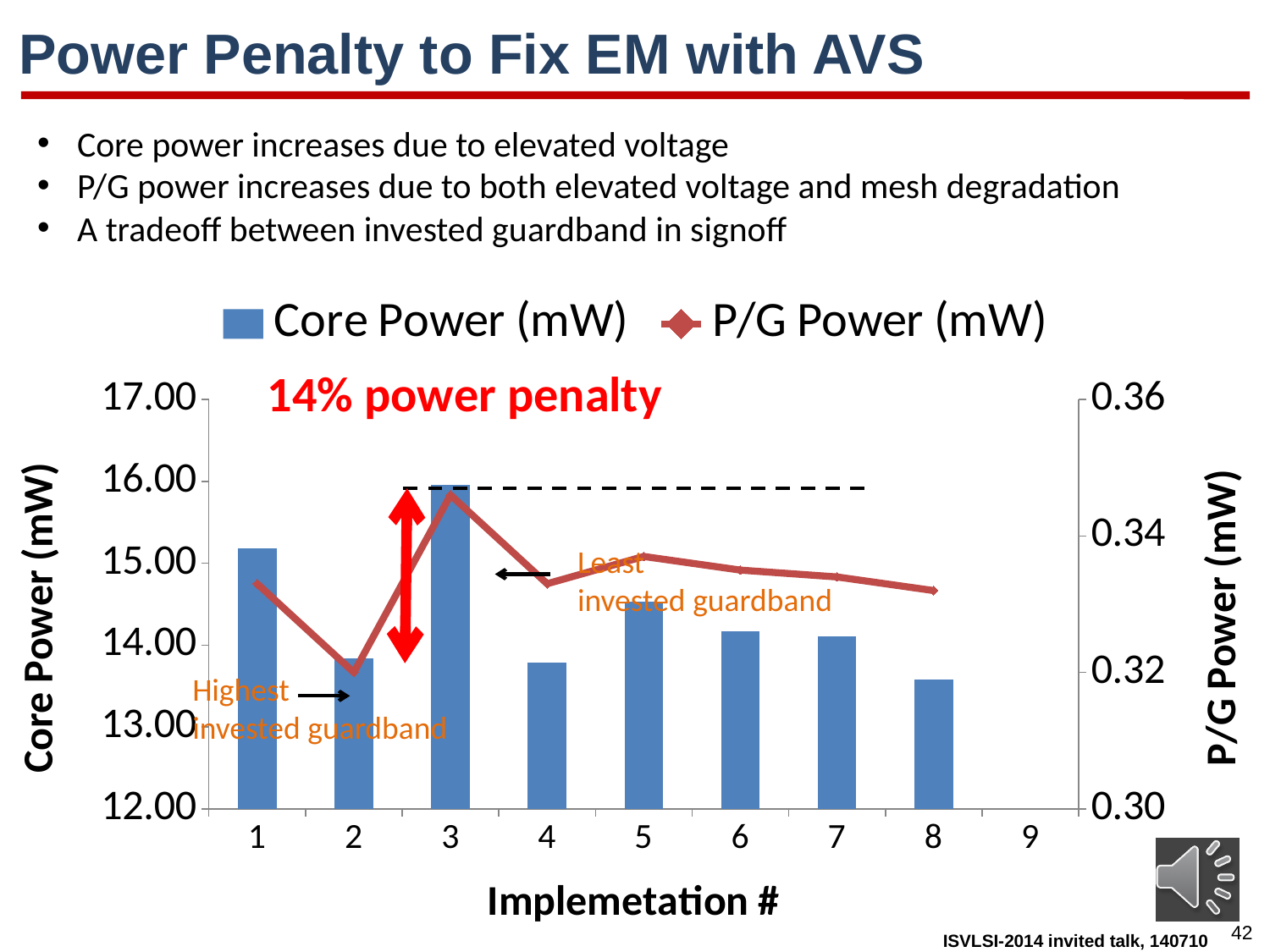
Which implementation has the lowest Core Power (mW)? 8 How many series does the legend list? 2 Which implementation has the highest Core Power (mW)? 3 How many implementations have a Core Power bar plotted? 8 Which implementation has the highest P/G Power (mW)? 3 Is the Core Power for implementation 8 greater or less than 14.00? less Which implementation has the lowest P/G Power (mW)? 2 Is the Core Power for implementation 1 greater or less than 15.00? greater Which has the larger Core Power, implementation 1 or implementation 2? Implementation 1 What kind of chart is shown on the slide? A combined bar and line chart Is the P/G Power for implementation 3 greater or less than 0.34? greater What power penalty is annotated in red on the chart? 14% power penalty